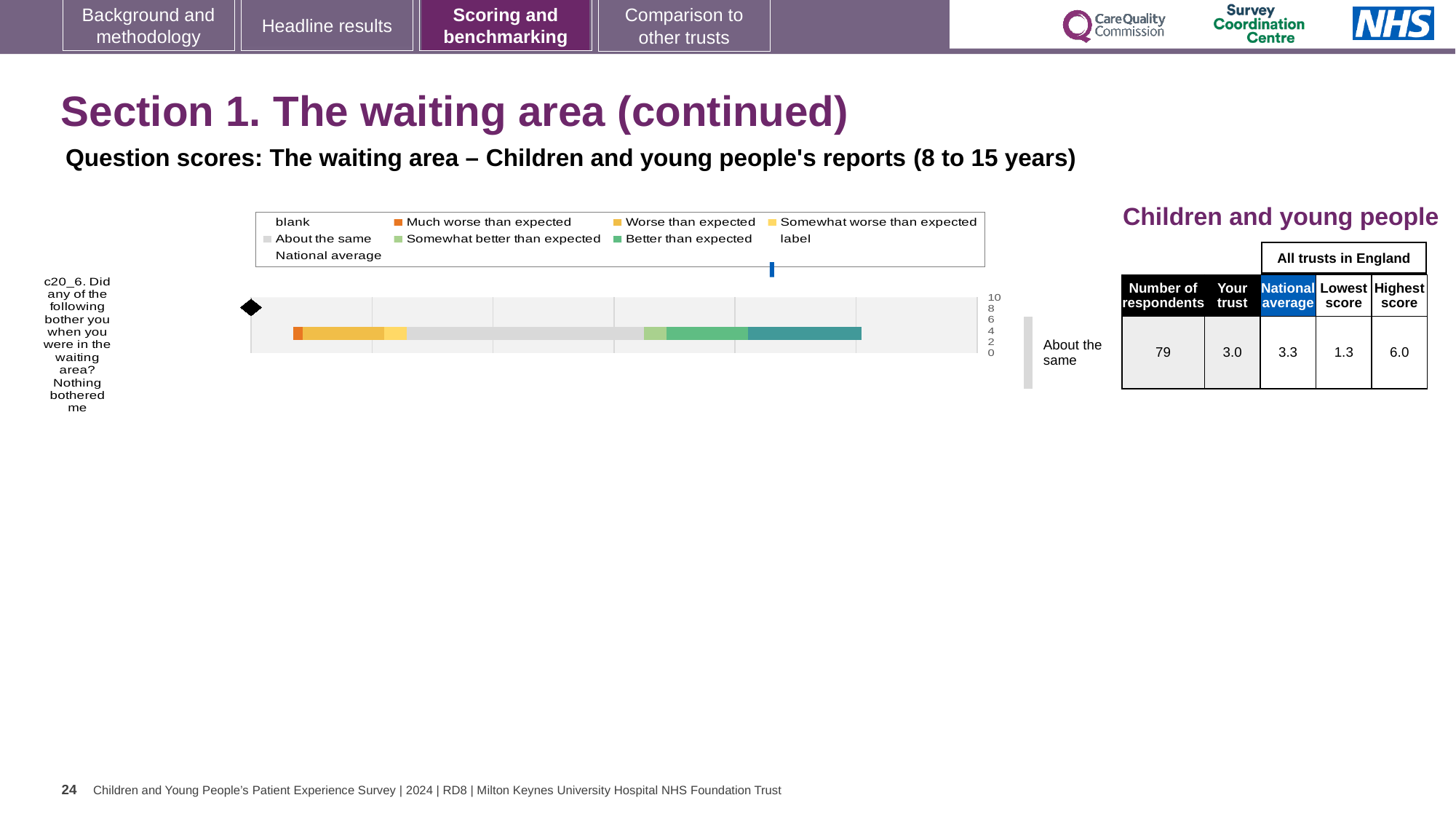
What is the lowest score among all trusts in England for question c20_6? 1.3 Which legend entry is shown in orange? Much worse than expected What is the 'Your trust' score for question c20_6 (Nothing bothered me in the waiting area)? 3.0 How many question categories are plotted in the bar chart? 1 Which is larger for question c20_6: the 'Your trust' score or the national average? National average What kind of chart is shown on the slide? bar chart What benchmark category is the trust's result for question c20_6 labelled as? About the same How many entries does the chart legend list? 9 What is the difference between the highest score and the lowest score for question c20_6? 4.7 What is the highest score among all trusts in England for question c20_6? 6.0 What is the national average score for question c20_6? 3.3 How many respondents answered question c20_6? 79